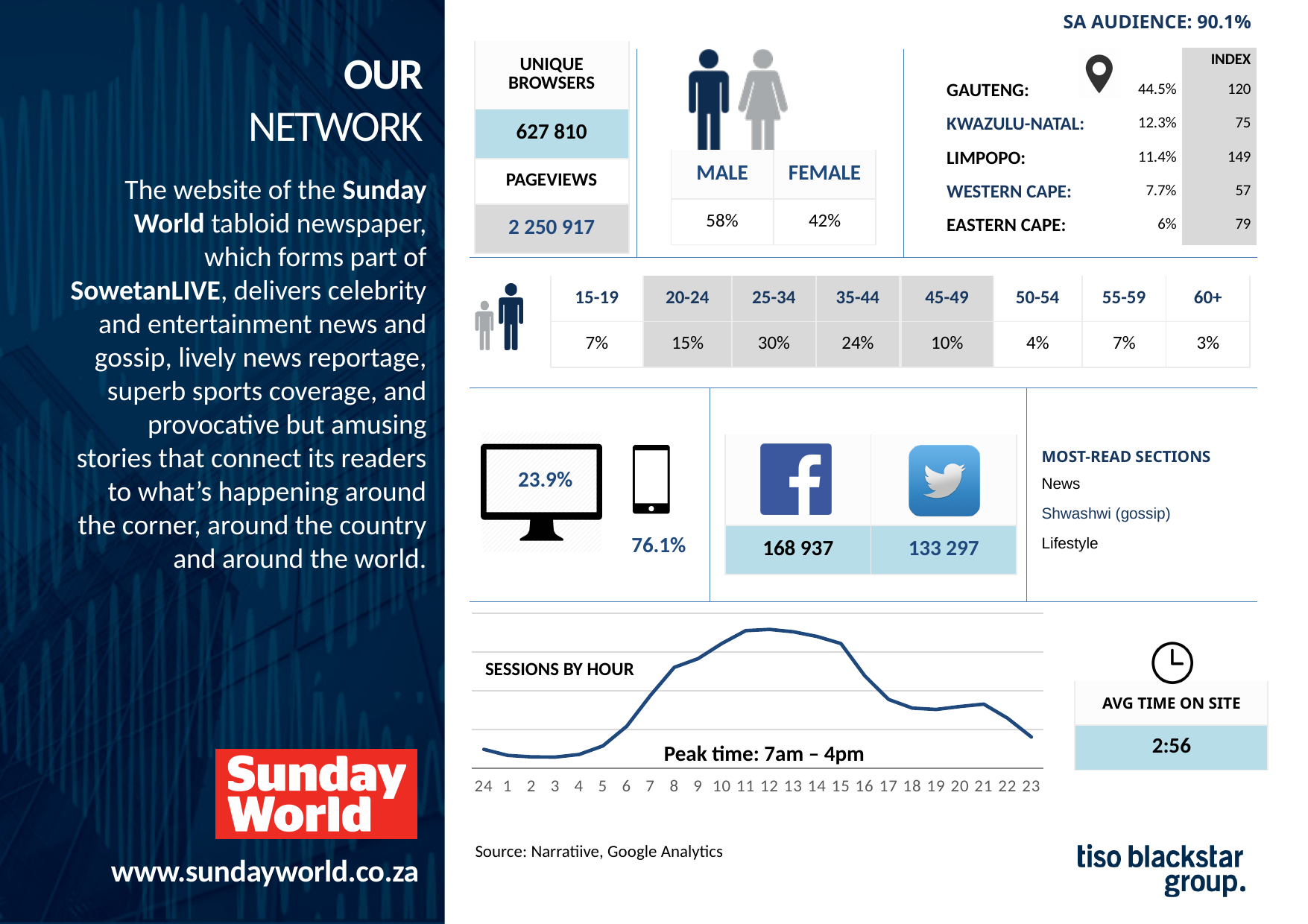
How many hour labels are shown on the x axis of the 'Sessions by hour' chart? 24 What kind of chart is the 'Sessions by hour' chart? line chart On the 'Sessions by hour' chart, which hour has more sessions, hour 8 or hour 23? hour 8 On the 'Sessions by hour' chart, do sessions rise or fall between hour 21 and hour 23? fall On the 'Sessions by hour' chart, which hour has more sessions, hour 2 or hour 20? hour 20 According to the annotation on the 'Sessions by hour' chart, what is the peak time? 7am – 4pm On the 'Sessions by hour' chart, which hour has more sessions, hour 12 or hour 3? hour 12 On the 'Sessions by hour' chart, do sessions rise or fall between hour 5 and hour 11? rise What is the title of the line chart at the bottom of the slide? SESSIONS BY HOUR On the 'Sessions by hour' chart, do sessions rise or fall between hour 15 and hour 19? fall